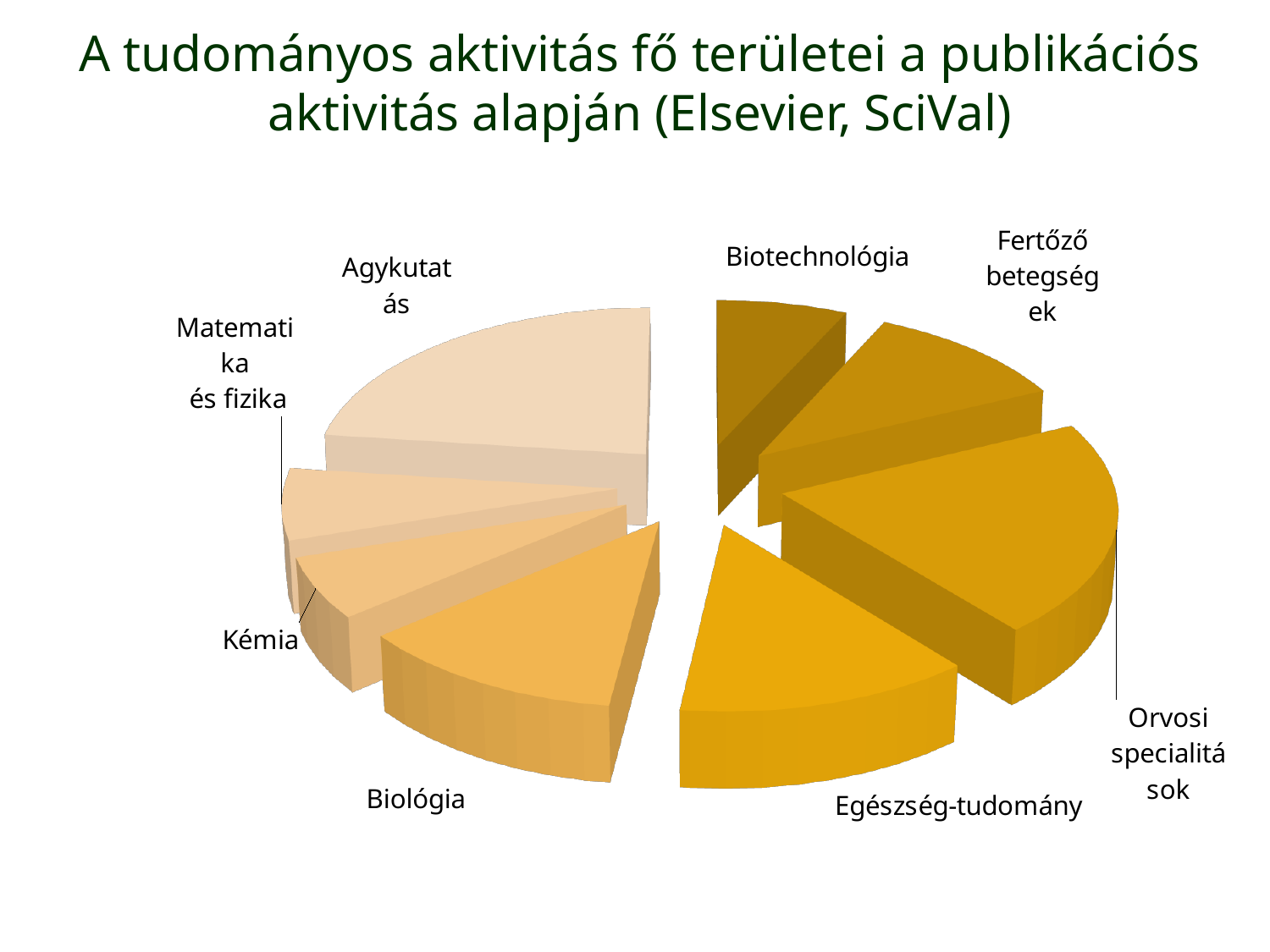
Which category has the largest slice of the pie chart? Agykutatás How many slices does the pie chart have? 8 Which slice is larger, Biológia or Matematika és fizika? Biológia Which slice is larger, Orvosi specialitások or Biotechnológia? Orvosi specialitások Does the pie chart display numeric data labels on its slices? No Which slice is larger, Fertőző betegségek or Kémia? Fertőző betegségek What is the title of the slide containing the pie chart? A tudományos aktivitás fő területei a publikációs aktivitás alapján (Elsevier, SciVal) What kind of chart is shown on the slide? pie chart